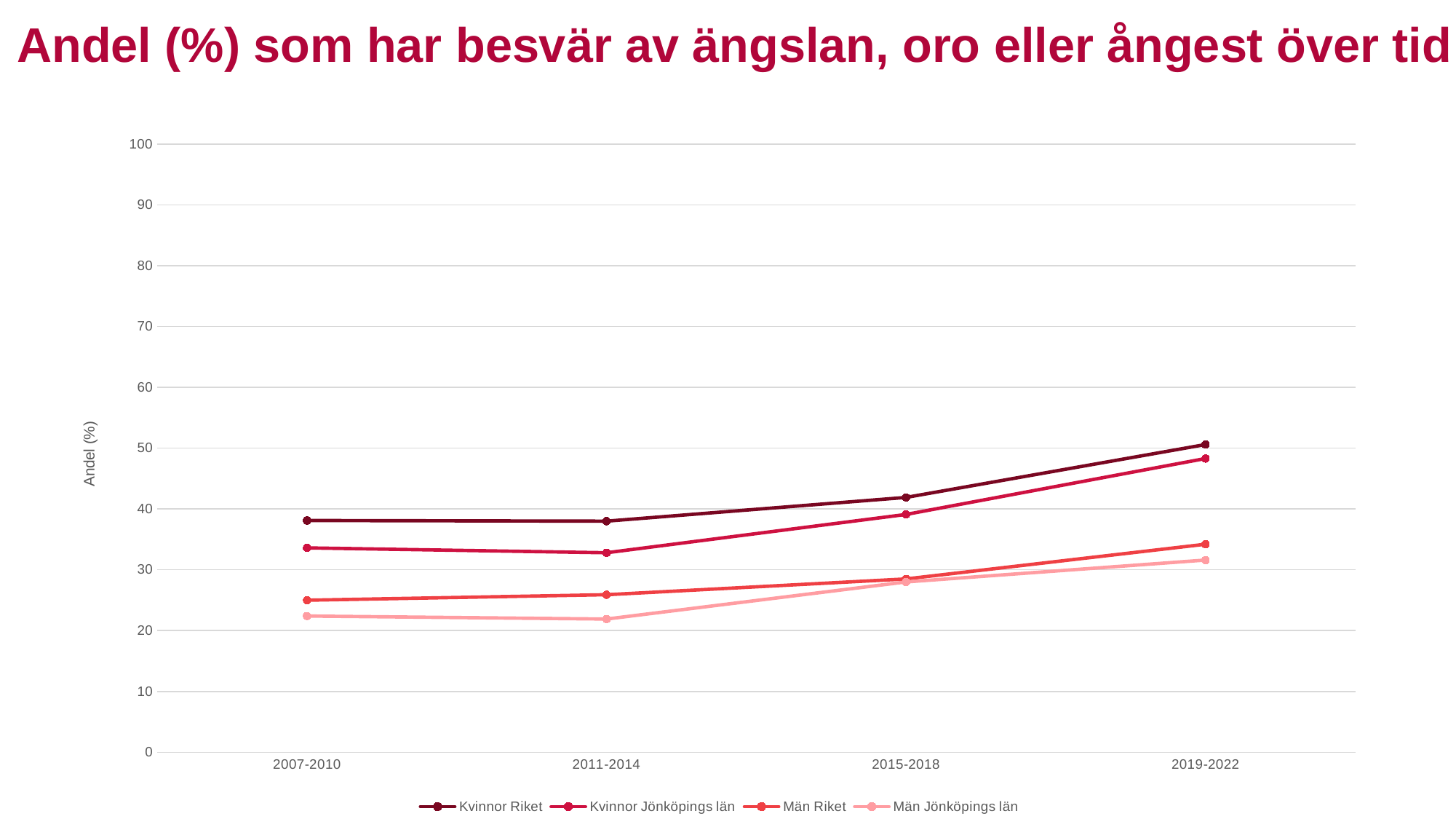
Is the value for Män Riket in 2019-2022 greater or less than 30? greater What is the label on the y axis? Andel (%) Is the value for Kvinnor Jönköpings län in 2007-2010 greater or less than 30? greater Is the value for Män Jönköpings län in 2011-2014 greater or less than 30? less In 2007-2010, which is larger: Kvinnor Riket or Kvinnor Jönköpings län? Kvinnor Riket Which series has the highest value in 2019-2022? Kvinnor Riket How many time periods are shown on the x axis? 4 Which series has the lowest value in 2007-2010? Män Jönköpings län What kind of chart is shown on the slide? line chart Do the values for Kvinnor Jönköpings län rise or fall between 2011-2014 and 2019-2022? rise How many series does the legend list? 4